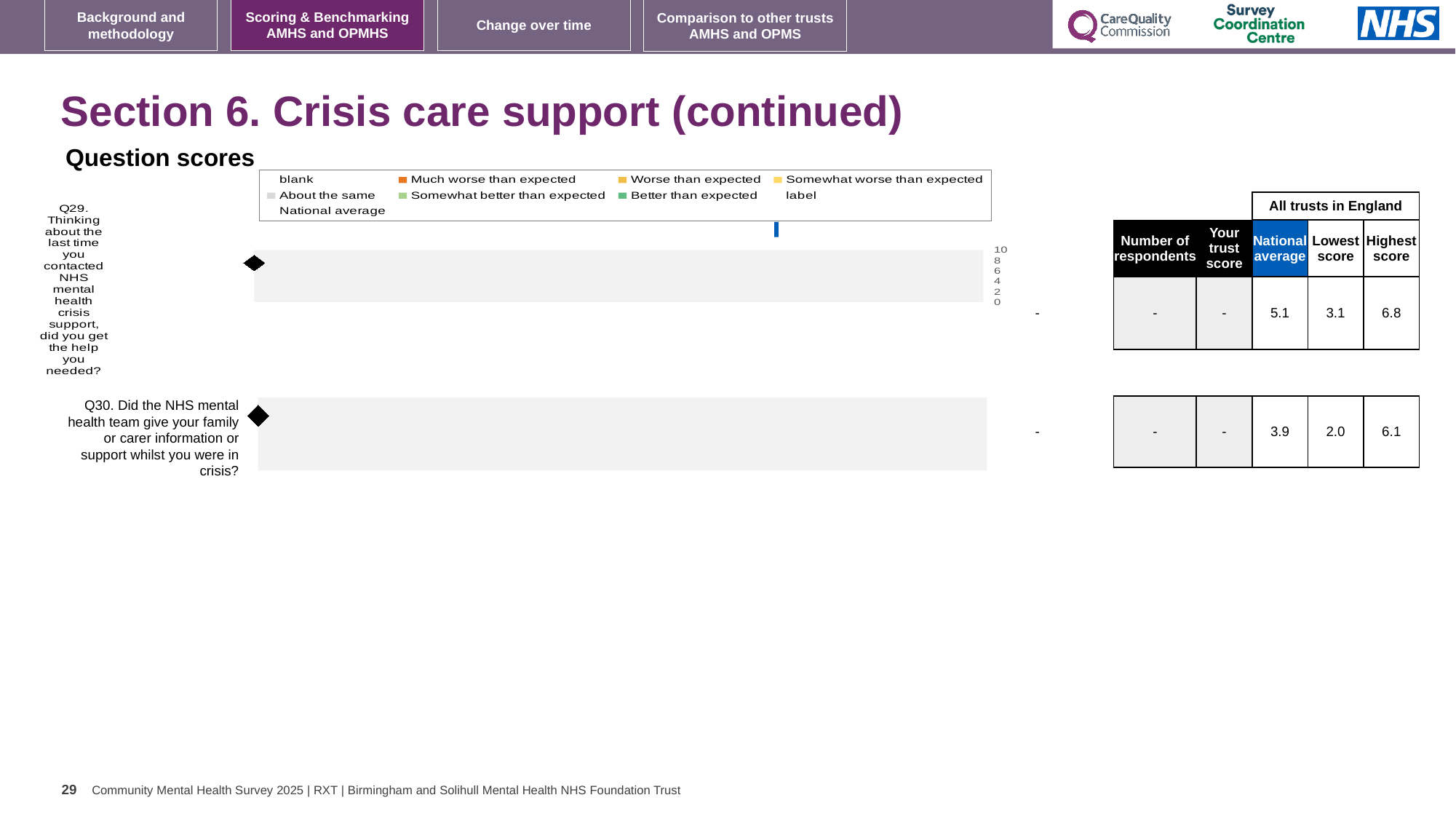
What is the highest tick value shown on the axis of the Question scores chart? 10 In the Question scores chart legend, what colour is the 'Much worse than expected' entry? orange How many question rows are plotted in the Question scores chart? 2 What is the lowest tick value shown on the axis of the Question scores chart? 0 In the Question scores chart legend, what colour is the 'Better than expected' entry? green What kind of chart is used for the Question scores? bar chart